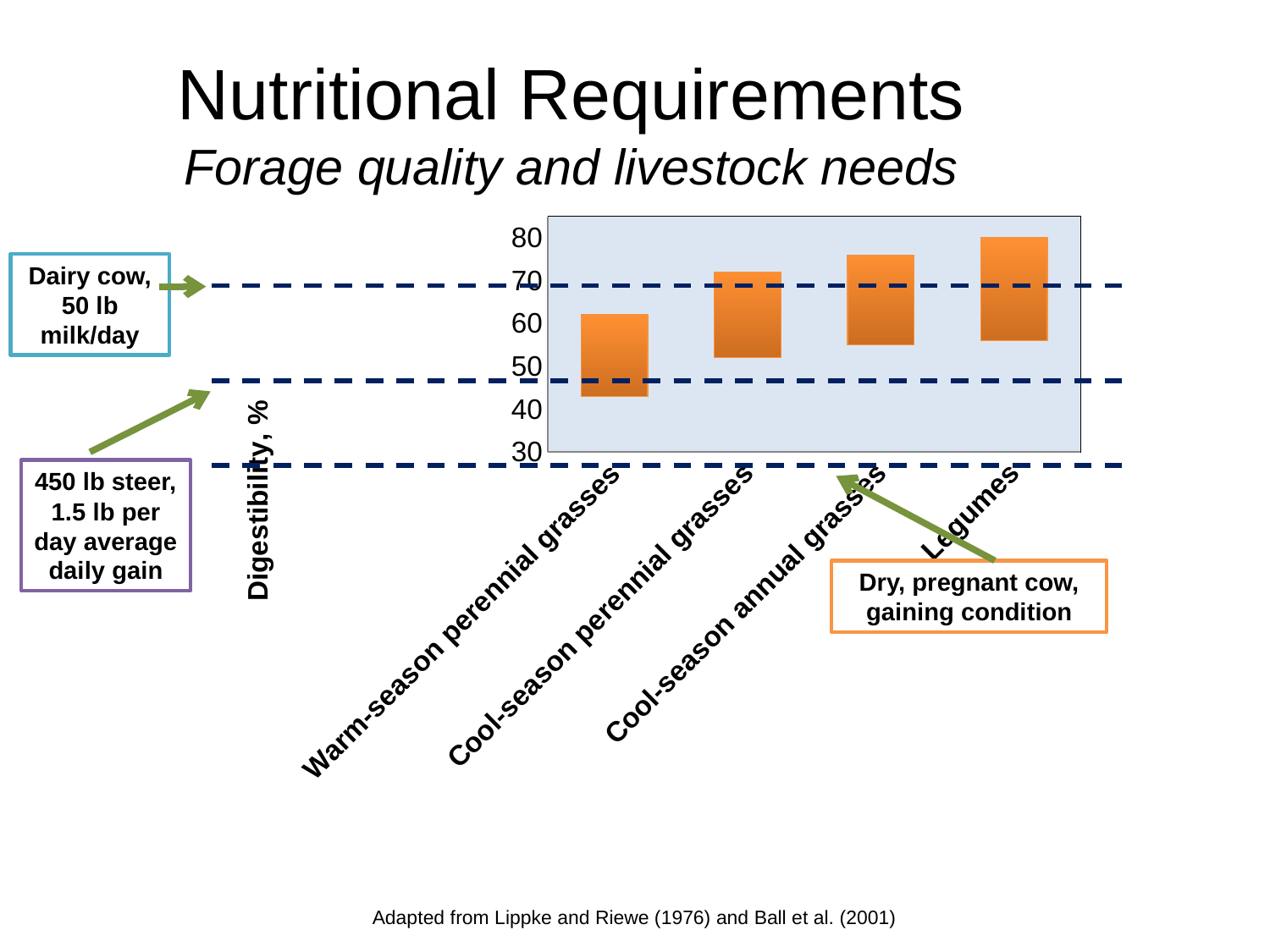
What is the label of the y axis of the chart? Digestibility, % Is the bottom of the bar for Legumes greater or less than 50? greater What kind of chart is shown on the slide? bar chart How many dashed horizontal lines marking livestock requirements cross the chart? 3 Which forage category reaches the highest digestibility on the chart? Legumes How many forage categories are shown on the x axis of the chart? 4 Is the top of the bar for Warm-season perennial grasses greater or less than 70? less Is the bottom of the bar for Warm-season perennial grasses greater or less than 50? less Which forage category has the lowest digestibility on the chart? Warm-season perennial grasses Which reaches a higher digestibility, Legumes or Warm-season perennial grasses? Legumes Do the digestibility bars rise or fall moving from left to right along the x axis? rise